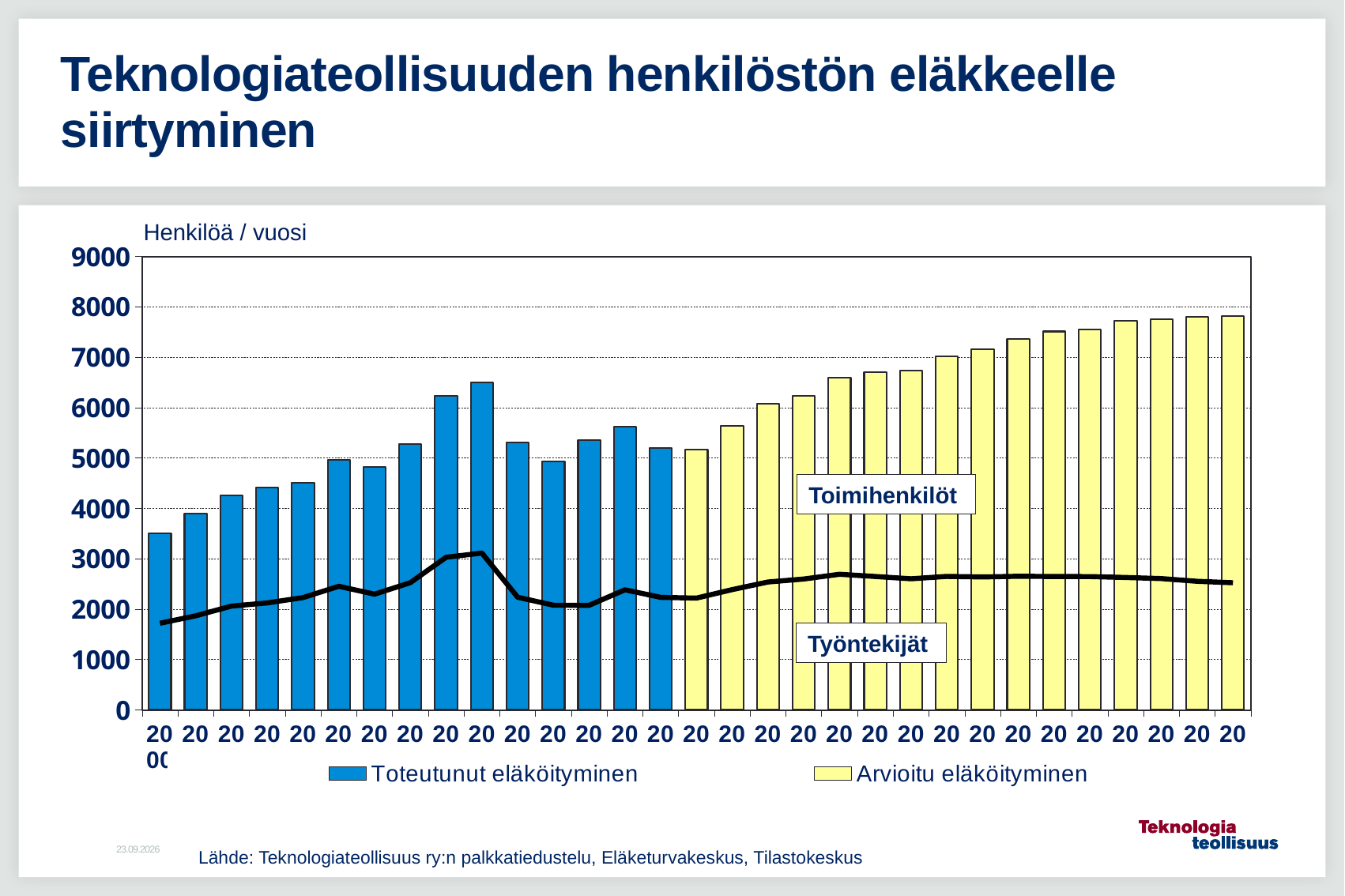
Is the first (leftmost) blue bar greater or less than 4000? less What is the label shown above the vertical axis? Henkilöä / vuosi Is the value of the black line at the leftmost point greater or less than 2000? less What are the two series named in the legend? Toteutunut eläköityminen and Arvioitu eläköityminen Which series contains the tallest bar on the chart, Toteutunut eläköityminen or Arvioitu eläköityminen? Arvioitu eläköityminen Is the tallest blue bar (Toteutunut eläköityminen) greater or less than 6000? greater What kind of chart is shown on the slide? bar and line chart How many series does the legend list? 2 How many blue Toteutunut eläköityminen bars are plotted? 15 Which series is drawn with blue bars? Toteutunut eläköityminen Do the yellow Arvioitu eläköityminen bars generally rise or fall from left to right? rise